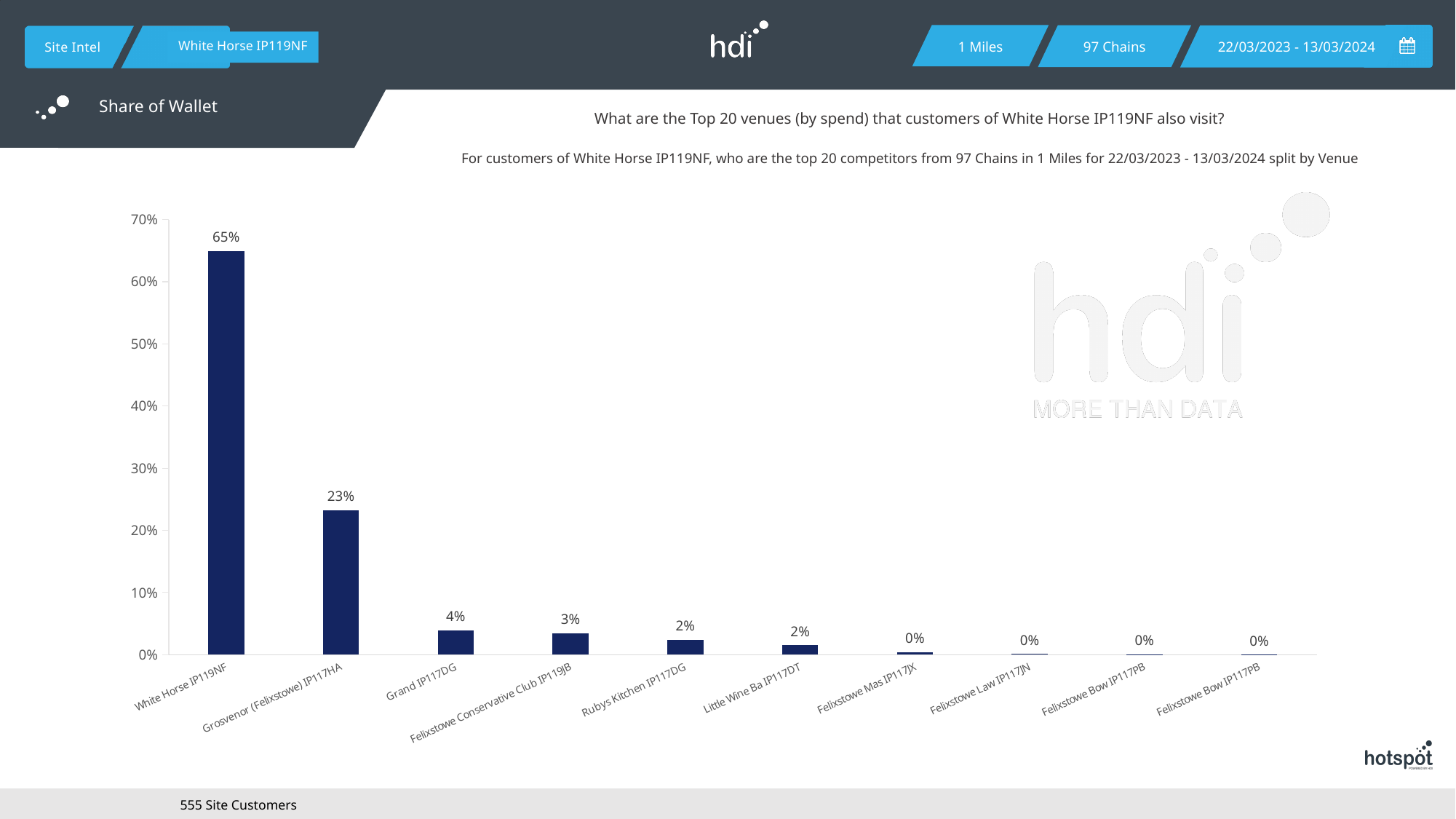
What is the value for White Horse IP119NF? 65% How many venues are shown on the chart? 10 Do the values rise or fall from left to right along the x axis? fall What is the value for Grand IP117DG? 4% What is the value for Felixstowe Conservative Club IP119JB? 3% Which is larger, the value for Grosvenor (Felixstowe) IP117HA or the value for Grand IP117DG? Grosvenor (Felixstowe) IP117HA What is the value for Grosvenor (Felixstowe) IP117HA? 23% Which venue has the highest value? White Horse IP119NF Is the value for White Horse IP119NF greater or less than 60%? greater What is the difference between the values for White Horse IP119NF and Grosvenor (Felixstowe) IP117HA? 42 percentage points What is the value for Rubys Kitchen IP117DG? 2% What kind of chart is shown on the slide? bar chart